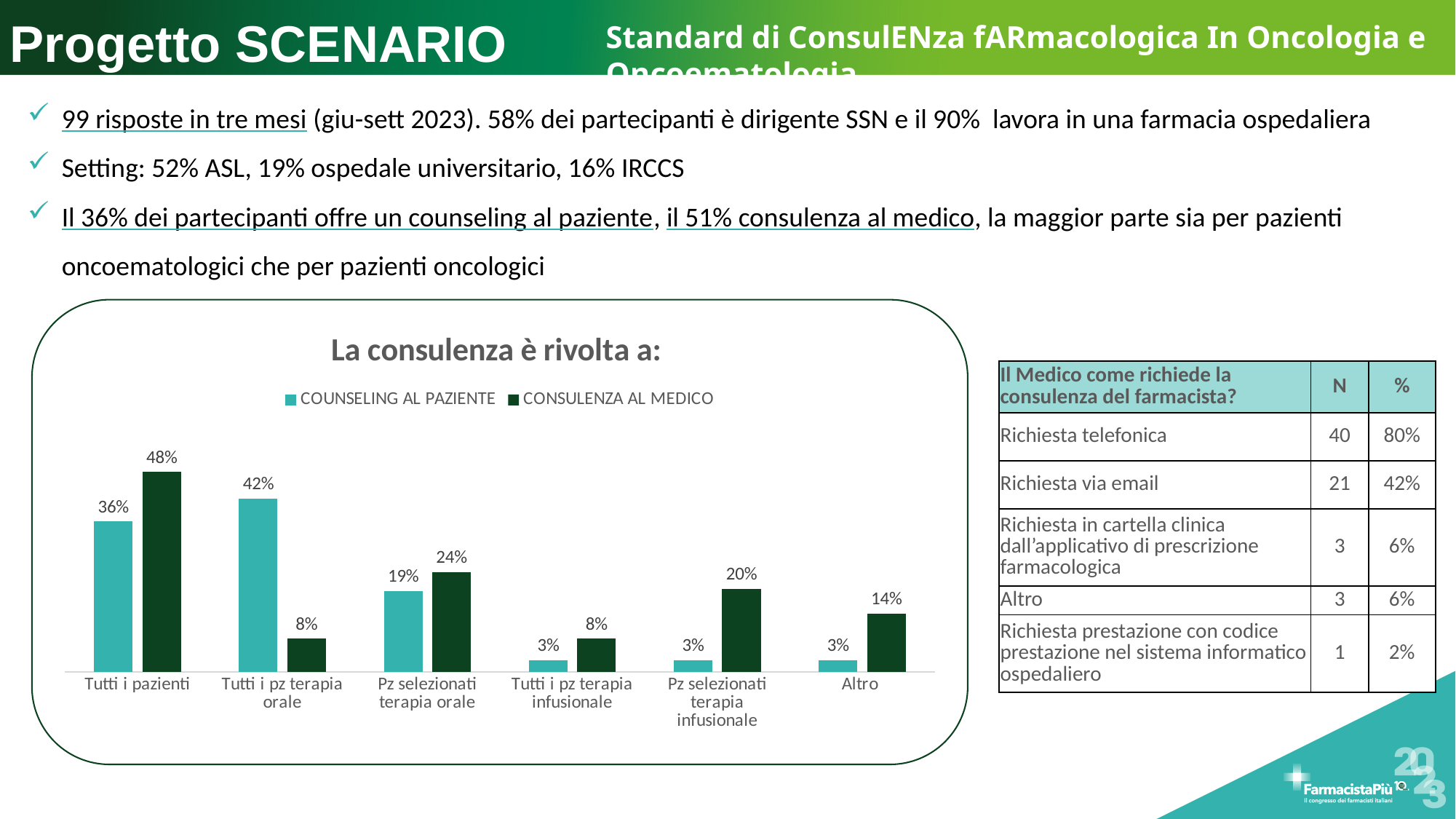
What is the title of the chart? La consulenza è rivolta a: Which category has the highest value for CONSULENZA AL MEDICO? Tutti i pazienti Which category has the lowest value for CONSULENZA AL MEDICO? Tutti i pz terapia orale and Tutti i pz terapia infusionale (both 8%) In the category 'Pz selezionati terapia orale', which series has the larger value? CONSULENZA AL MEDICO What type of chart is shown on the slide? Bar chart What is the value for CONSULENZA AL MEDICO in the category 'Pz selezionati terapia infusionale'? 20% How many series does the chart legend list? 2 How many categories are shown on the x axis of the chart? 6 What is the difference between CONSULENZA AL MEDICO and COUNSELING AL PAZIENTE in the category 'Tutti i pz terapia orale'? 34% What is the value for COUNSELING AL PAZIENTE in the category 'Tutti i pz terapia orale'? 42% What is the value for COUNSELING AL PAZIENTE in the category 'Tutti i pazienti'? 36% What is the value for CONSULENZA AL MEDICO in the category 'Tutti i pazienti'? 48%